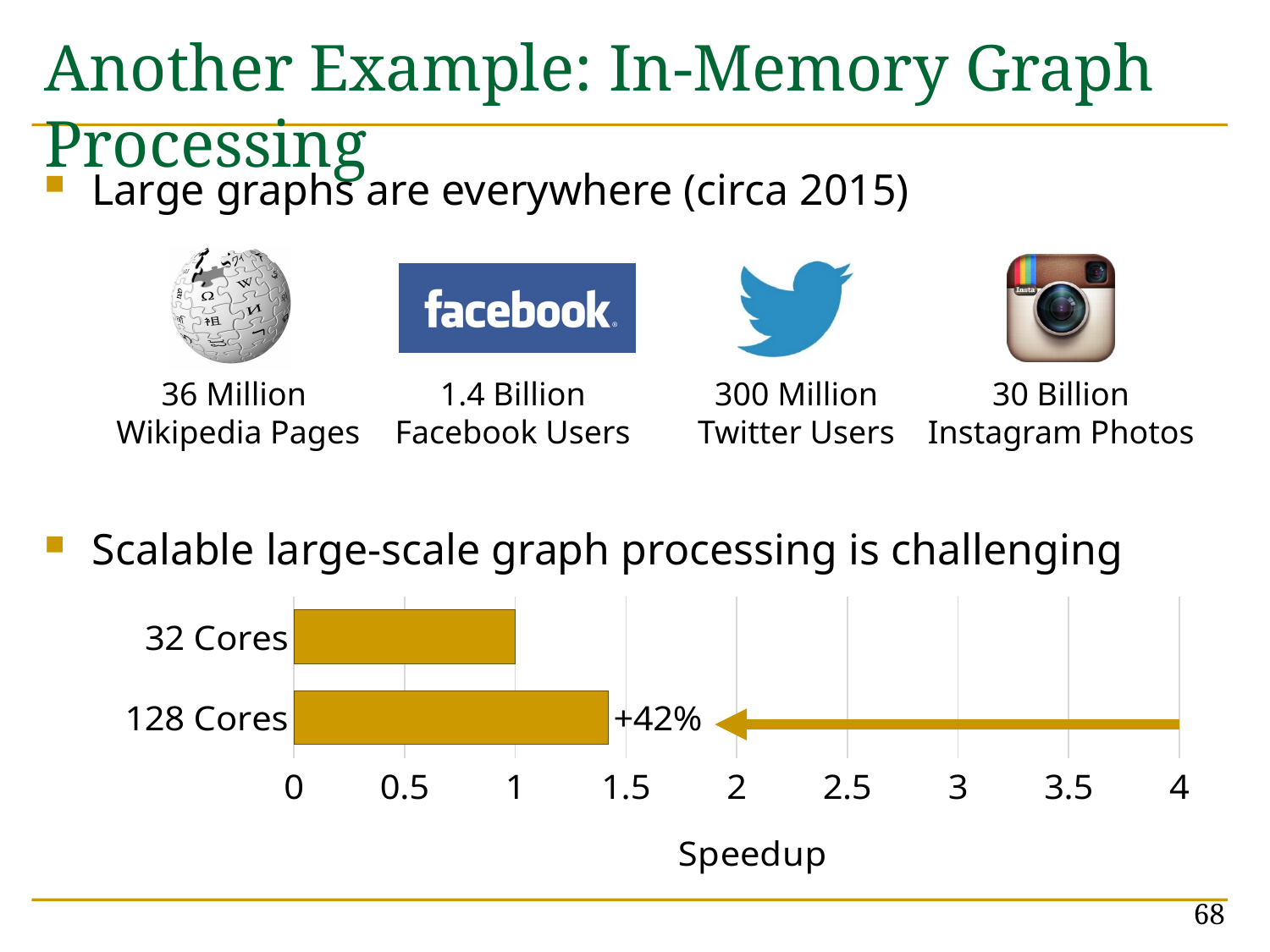
What percentage annotation is shown next to the 128 Cores bar? +42% Which category has the higher speedup, 32 Cores or 128 Cores? 128 Cores Is the speedup for 128 Cores greater or less than 2? less What kind of chart is shown on the slide? bar chart What is the maximum value shown on the x axis of the chart? 4 What is the label of the x axis of the chart? Speedup What is the speedup value for 32 Cores? 1 Is the speedup for 128 Cores greater or less than 1.5? less Which category has the lowest speedup? 32 Cores How many categories does the chart show? 2 Is the speedup for 128 Cores greater or less than 1? greater Which category has the highest speedup? 128 Cores